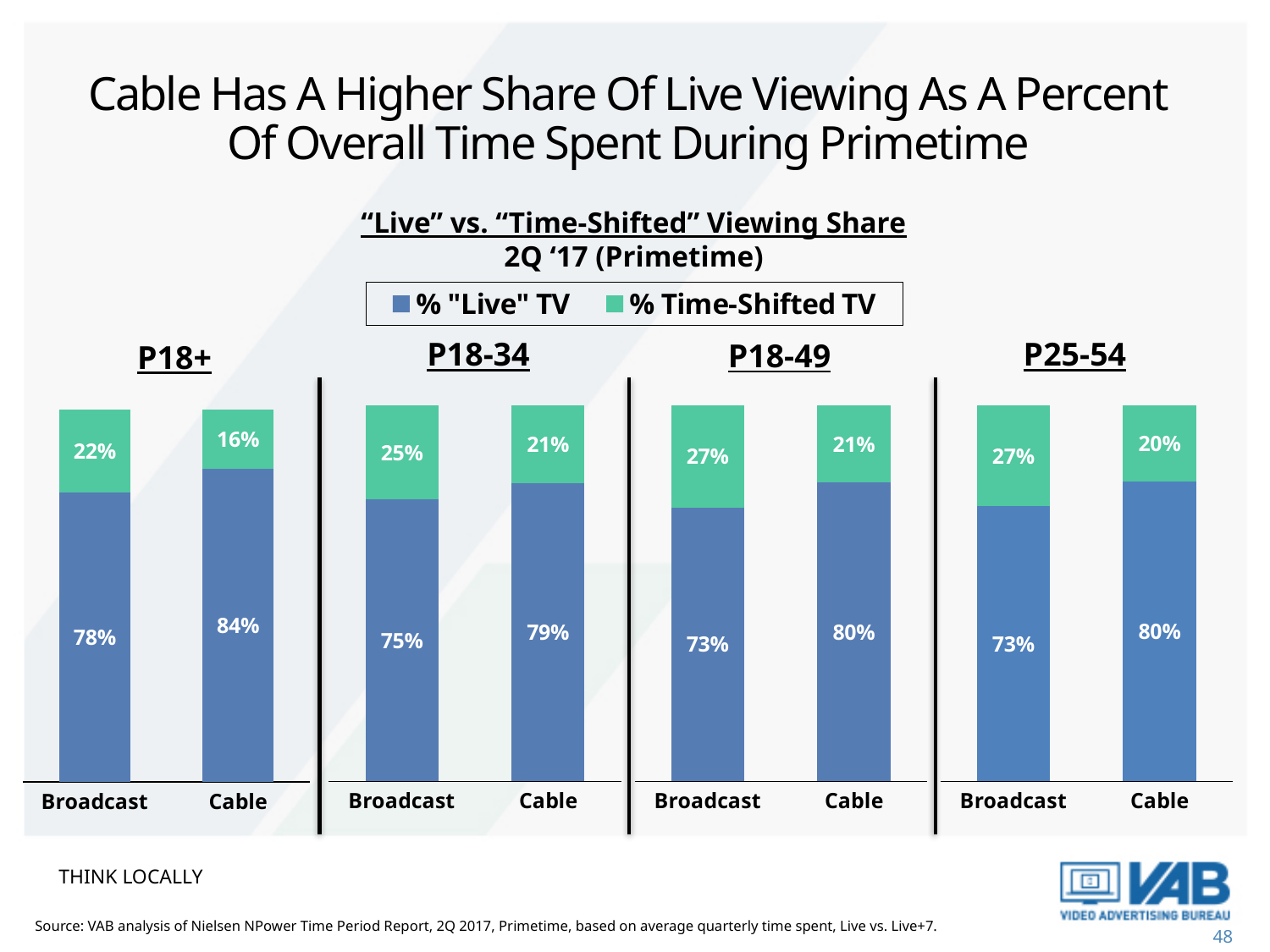
In the P25-54 panel, what is the % "Live" TV value for Broadcast? 73% What kind of chart is shown on the slide? Stacked bar chart In the P18-49 panel, what is the % Time-Shifted TV value for Cable? 21% How many series does the legend list? 2 Across all four panels, which bar has the lowest % Time-Shifted TV value? Cable in P18+ Across all four panels, which bar has the highest % "Live" TV value? Cable in P18+ In the P18-34 panel, what is the % Time-Shifted TV value for Broadcast? 25% In the P18+ panel, what is the % "Live" TV value for Cable? 84% In the P18+ panel, what is the difference between the % "Live" TV values for Cable and Broadcast? 6% In the P18-34 panel, what is the total of the stacked bar for Cable? 100% What colour represents % Time-Shifted TV in the legend? Green In the P18-49 panel, which has the larger % Time-Shifted TV value, Broadcast or Cable? Broadcast